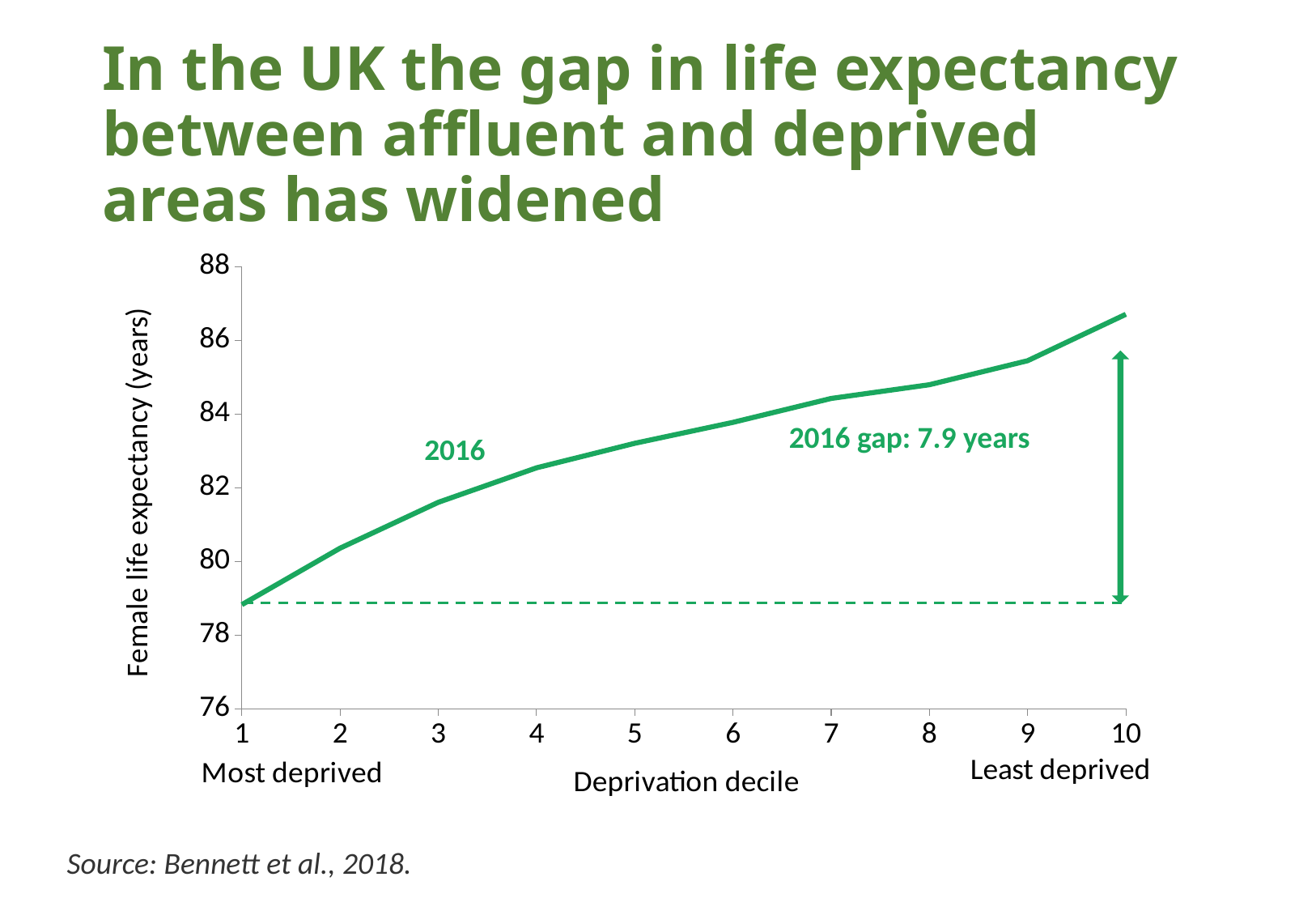
Is the female life expectancy for decile 5 greater or less than 82? greater Which deprivation decile has the lowest female life expectancy? 1 Which year does the plotted line represent? 2016 How many deprivation deciles are plotted along the x axis? 10 What is the label of the y axis? Female life expectancy (years) Which deprivation decile has the highest female life expectancy? 10 Is the female life expectancy for decile 10 greater or less than 86? greater Do the values rise or fall as the deprivation decile increases from 1 to 10? rise What kind of chart is shown on the slide? line chart Which has the higher female life expectancy, decile 3 or decile 8? decile 8 What is the 2016 gap in female life expectancy stated on the chart? 7.9 years Is the female life expectancy for decile 1 greater or less than 80? less